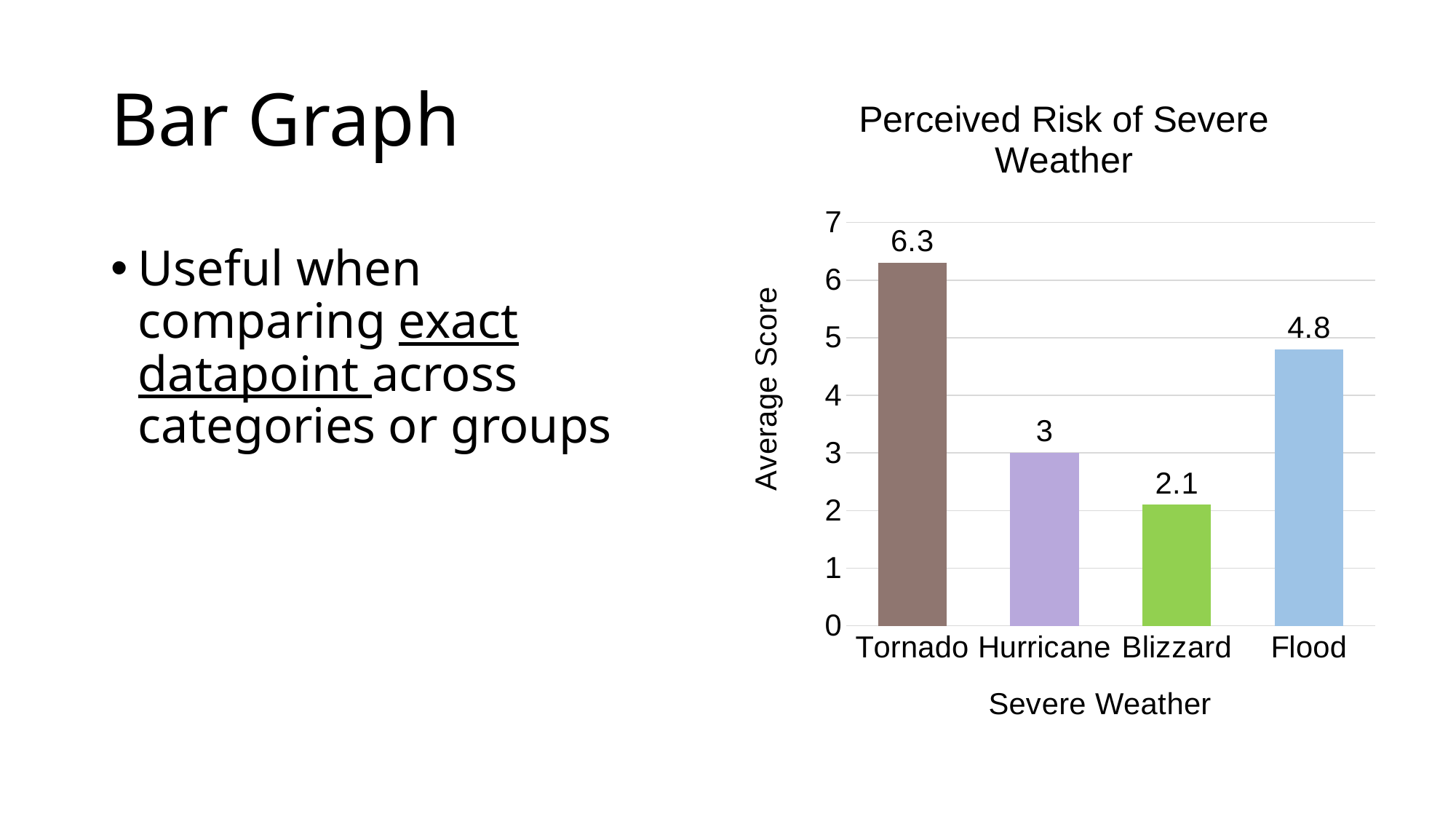
What is the average score for Tornado? 6.3 What is the average score for Flood? 4.8 How many severe weather categories are shown in the chart? 4 What kind of chart is shown on the slide? Bar chart What is the average score for Hurricane? 3 Which severe weather type has the lowest perceived risk score? Blizzard What is the difference between the average scores for Tornado and Flood? 1.5 Which has a higher average score, Hurricane or Flood? Flood What is the average score for Blizzard? 2.1 Which severe weather type has the highest perceived risk score? Tornado Is the value for Blizzard greater or less than 3? less What is the title of the chart? Perceived Risk of Severe Weather